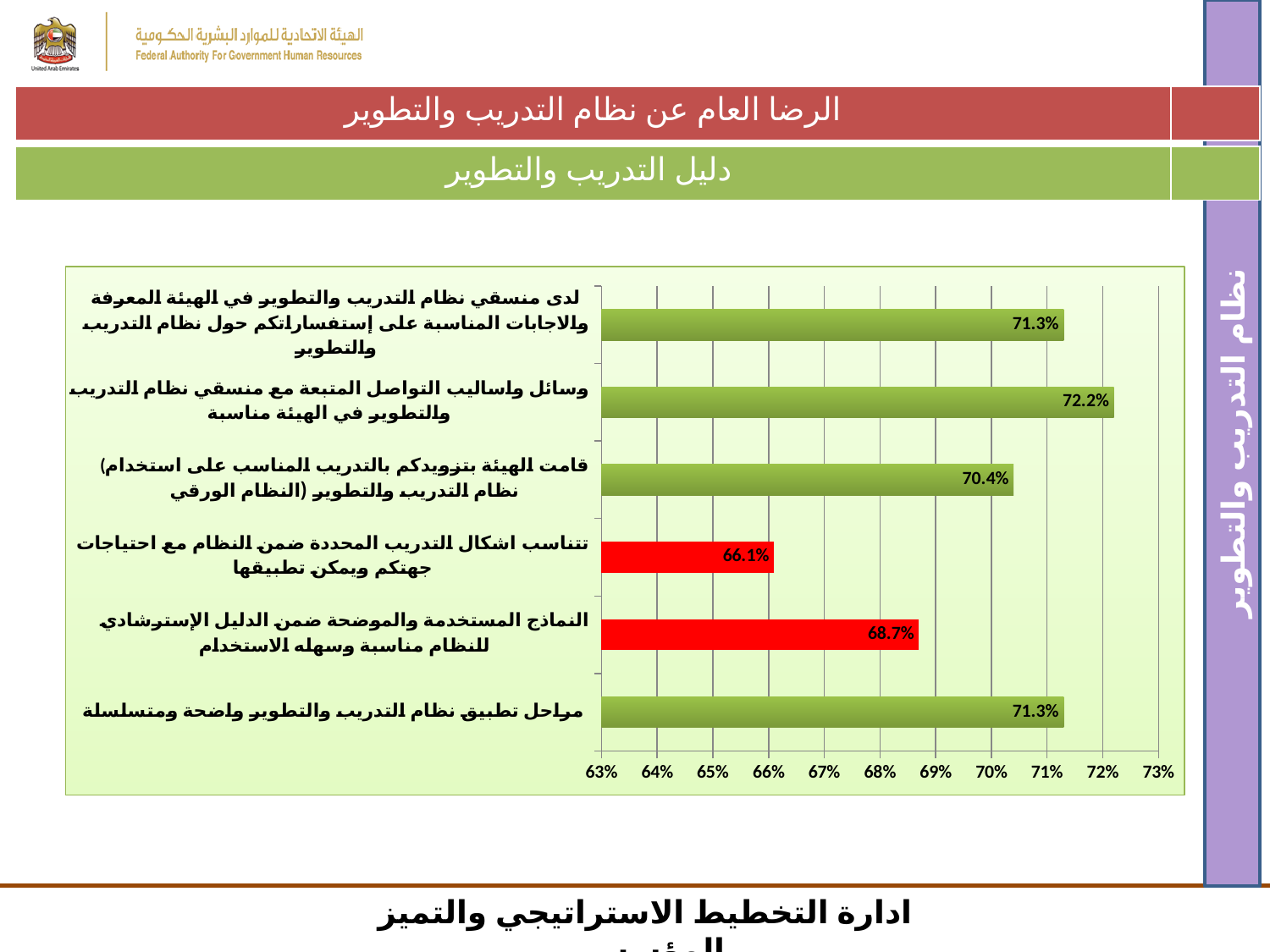
What kind of chart is shown on the slide? Bar chart Which category has the highest value in the chart? وسائل واساليب التواصل المتبعة مع منسقي نظام التدريب والتطوير في الهيئة مناسبة What is the value shown for the bar labelled "وسائل واساليب التواصل المتبعة مع منسقي نظام التدريب والتطوير في الهيئة مناسبة"? 72.2% What is the difference between the highest value (72.2%) and the lowest value (66.1%) in the chart? 6.1 percentage points Which category has the lowest value in the chart? تتناسب اشكال التدريب المحددة ضمن النظام مع احتياجات جهتكم ويمكن تطبيقها How many categories (bars) are shown in the chart? 6 How many bars in the chart are coloured red? 2 What is the value shown for the bar labelled "تتناسب اشكال التدريب المحددة ضمن النظام مع احتياجات جهتكم ويمكن تطبيقها"? 66.1% Which is larger: the value for "قامت الهيئة بتزويدكم بالتدريب المناسب على استخدام نظام التدريب والتطوير (النظام الورقي)" or the value for "النماذج المستخدمة والموضحة ضمن الدليل الإسترشادي للنظام مناسبة وسهلة الاستخدام"? قامت الهيئة بتزويدكم بالتدريب المناسب على استخدام نظام التدريب والتطوير (النظام الورقي) What is the value shown for the bar labelled "النماذج المستخدمة والموضحة ضمن الدليل الإسترشادي للنظام مناسبة وسهلة الاستخدام"? 68.7% What is the value shown for the bar labelled "مراحل تطبيق نظام التدريب والتطوير واضحة ومتسلسلة"? 71.3% Is the value for "النماذج المستخدمة والموضحة ضمن الدليل الإسترشادي للنظام مناسبة وسهلة الاستخدام" greater or less than 69%? less